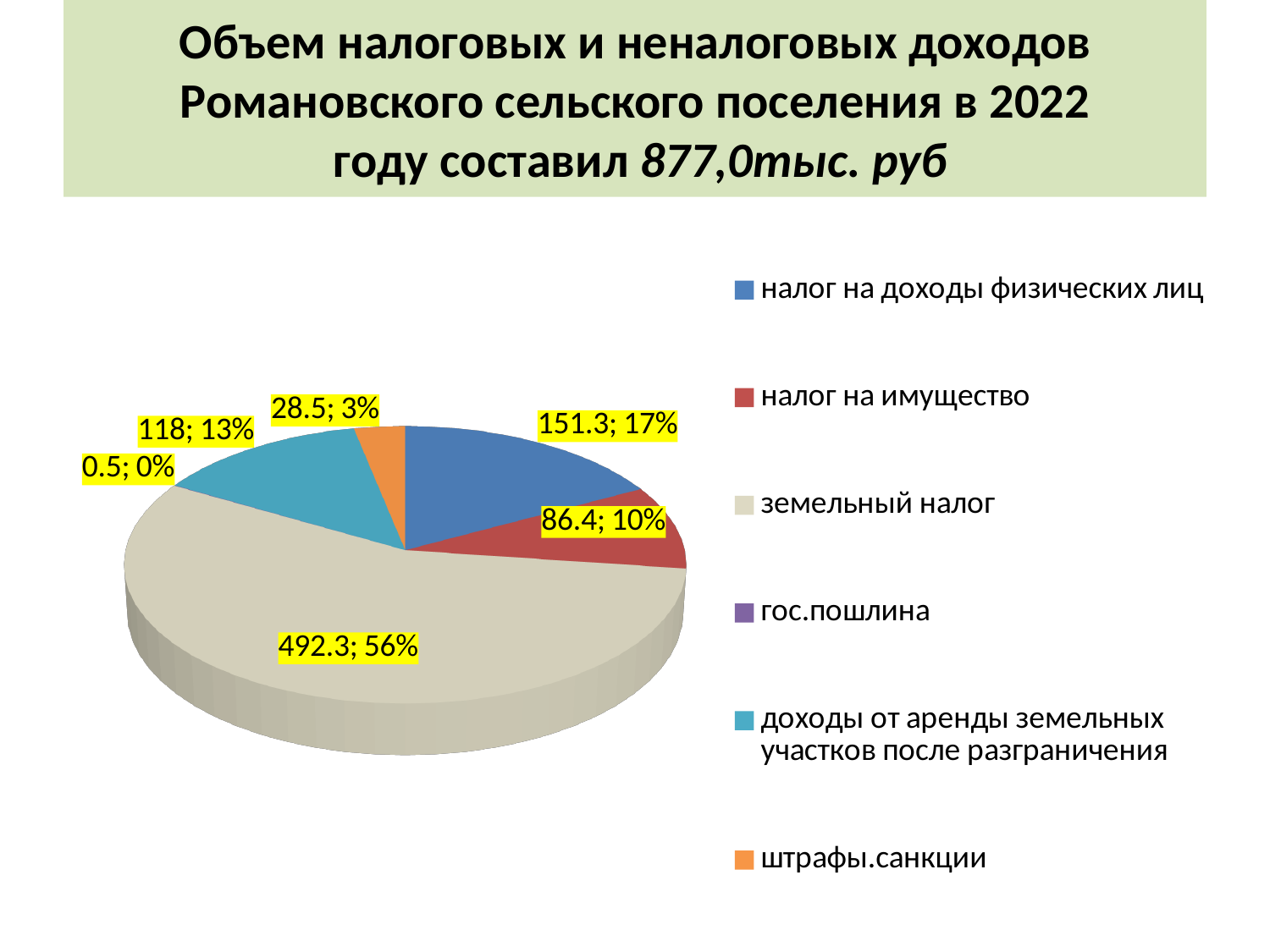
What share of the pie does штрафы.санкции take? 3% How many series does the legend list? 6 What kind of chart is shown on the slide? pie chart What share of the pie does земельный налог take? 56% What is the value for налог на имущество? 86.4 What is the value for земельный налог? 492.3 Which is larger, the value for доходы от аренды земельных участков после разграничения or the value for налог на имущество? доходы от аренды земельных участков после разграничения Which category has the largest slice? земельный налог Which category has the smallest slice? гос.пошлина What is the value for доходы от аренды земельных участков после разграничения? 118 What is the value for налог на доходы физических лиц? 151.3 What is the difference between the values for налог на доходы физических лиц and налог на имущество? 64.9